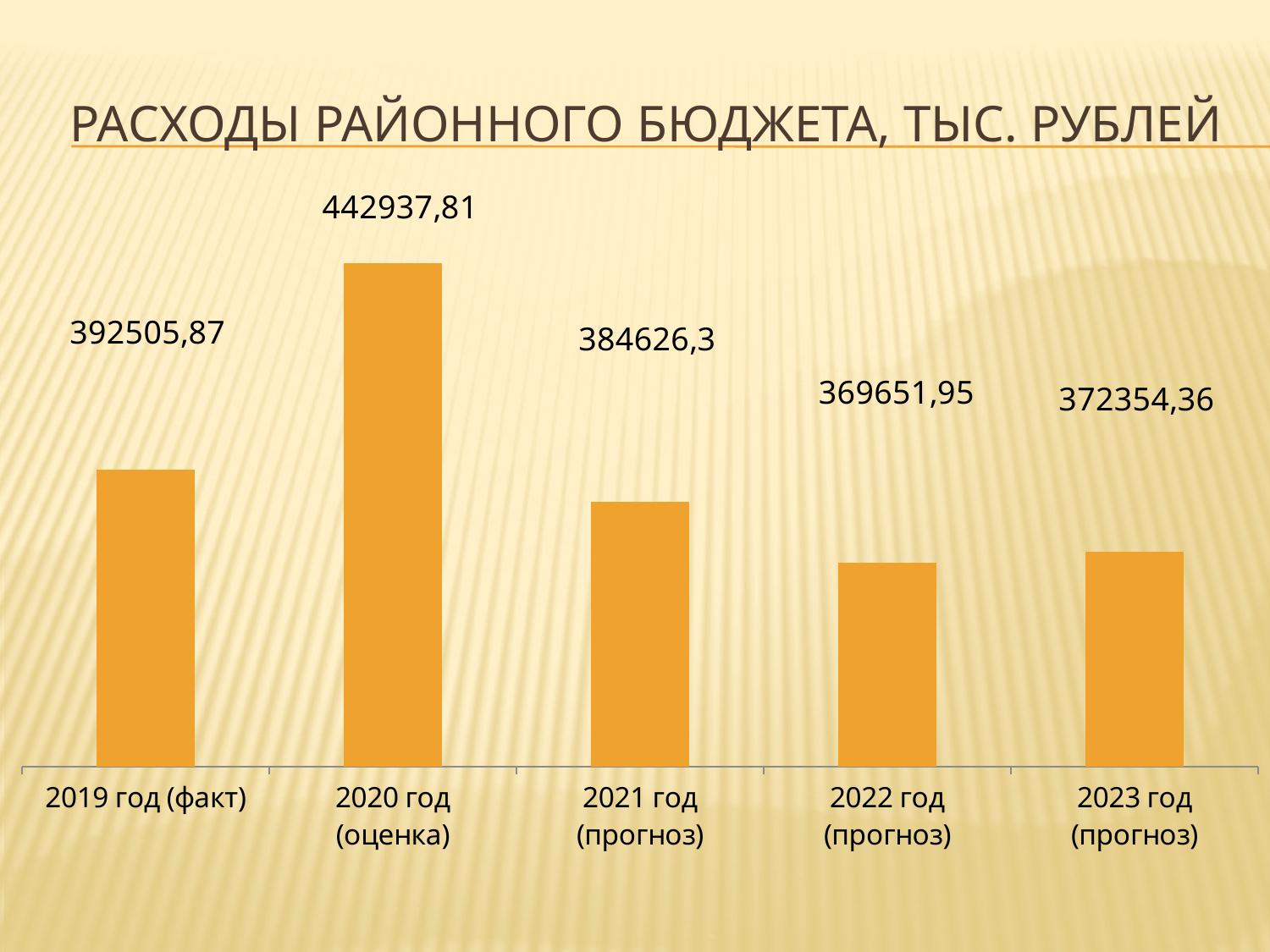
What is the value for 2020 год (оценка)? 442937,81 How many bars are shown in the chart? 5 Which year has the highest value? 2020 год (оценка) Which is larger, the value for 2019 год (факт) or 2021 год (прогноз)? 2019 год (факт) What is the value for 2022 год (прогноз)? 369651,95 What is the value for 2021 год (прогноз)? 384626,3 What is the difference between the values for 2020 год (оценка) and 2019 год (факт)? 50431,94 What is the title of the chart? РАСХОДЫ РАЙОННОГО БЮДЖЕТА, ТЫС. РУБЛЕЙ What kind of chart is shown on the slide? Bar chart What is the value for 2023 год (прогноз)? 372354,36 Which year has the lowest value? 2022 год (прогноз) What is the value for 2019 год (факт)? 392505,87